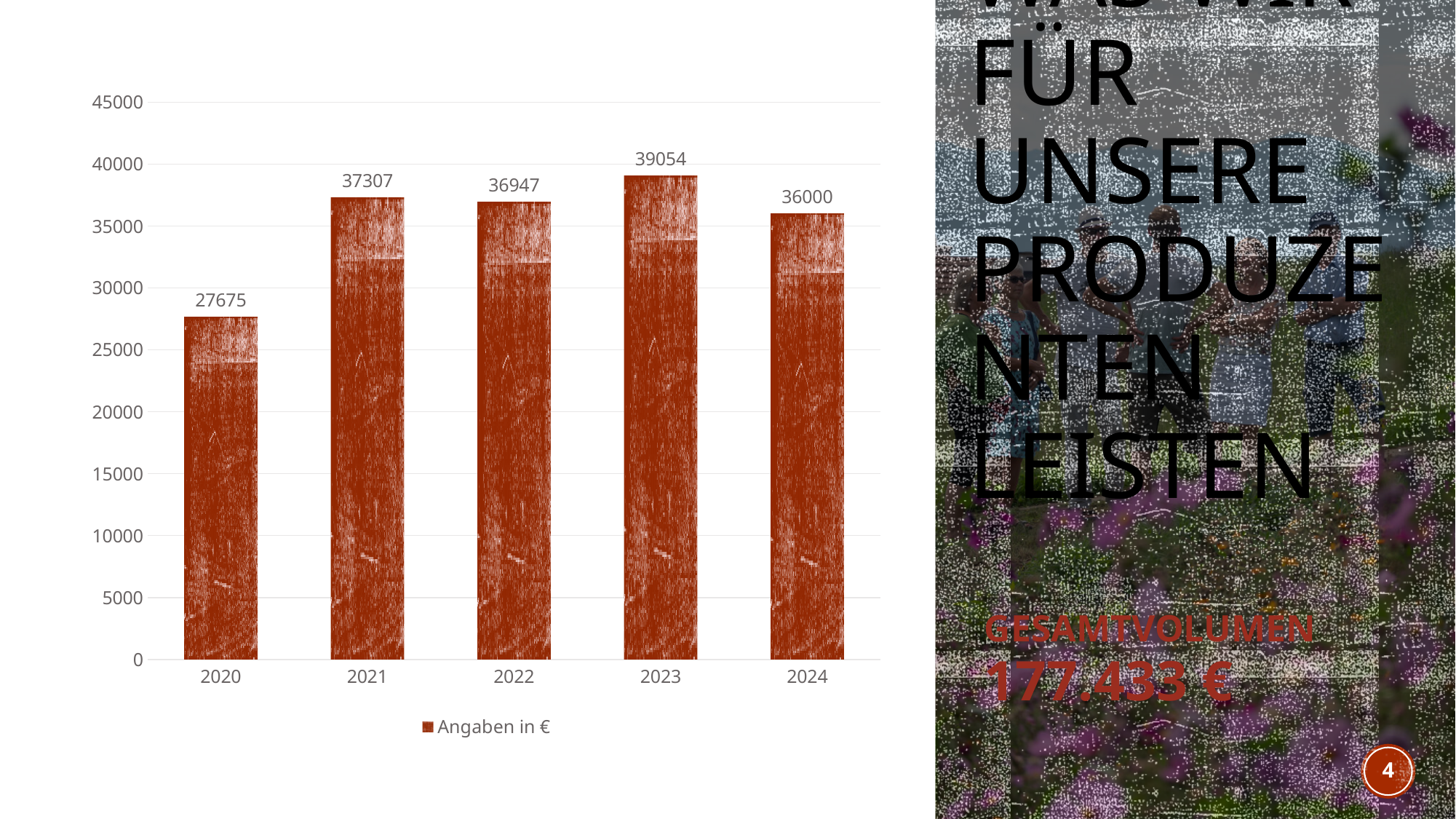
Which year has the lowest value? 2020 What is the value for 2020? 27675 Is the value for 2020 greater or less than 30000? less What is the value for 2024? 36000 What is the difference between the values for 2021 and 2022? 360 What is the legend entry for the series? Angaben in € How many years are shown on the x axis? 5 What is the difference between the values for 2023 and 2020? 11379 Which year has the highest value? 2023 What kind of chart is shown on the slide? bar chart What is the value for 2023? 39054 Which is larger, the value for 2021 or the value for 2024? 2021